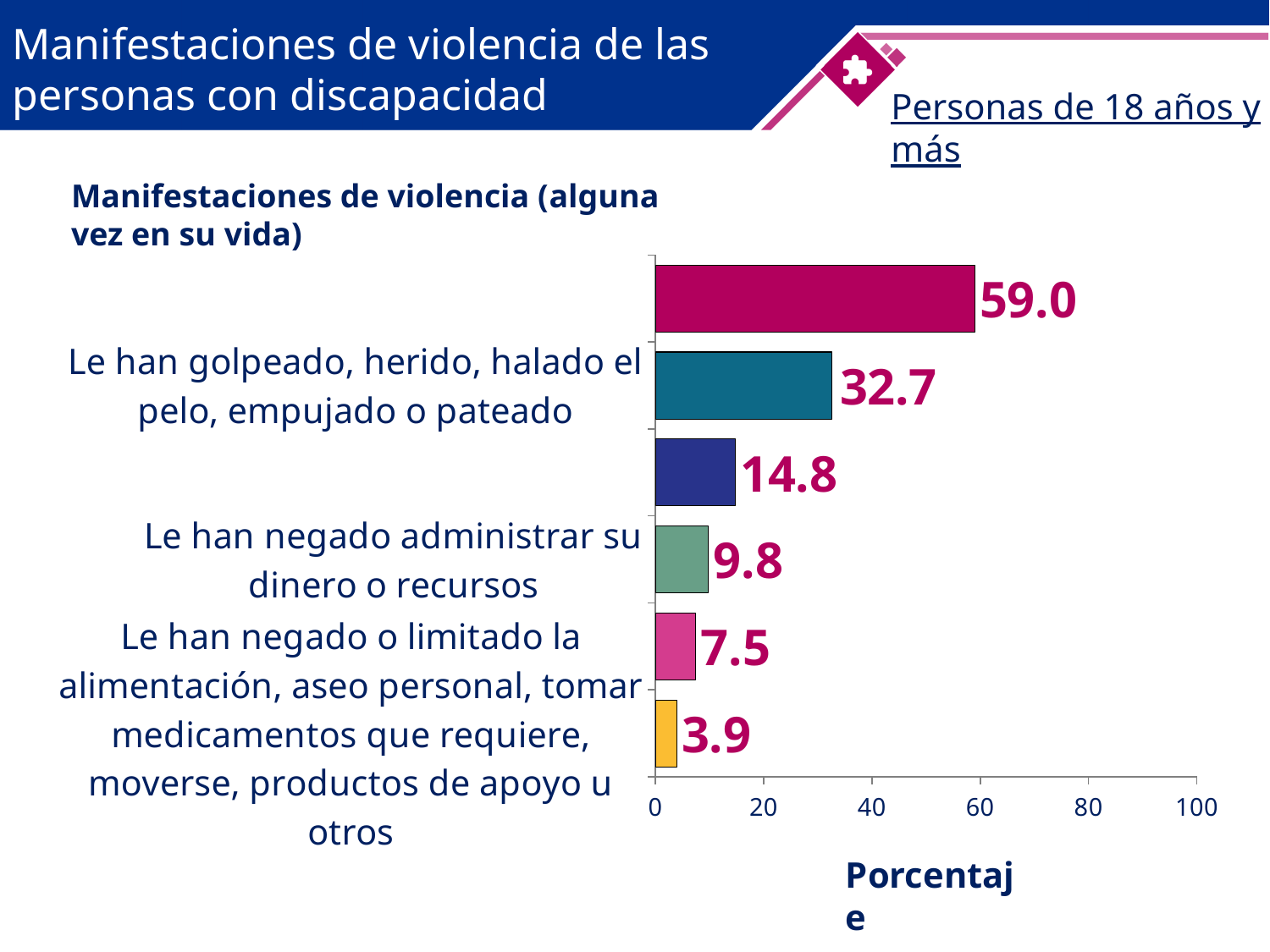
What is the value for 'Le han negado administrar su dinero o recursos'? 9.8 What is the value for 'Le han golpeado, herido, halado el pelo, empujado o pateado'? 32.7 What is the value of the fifth bar from the top? 7.5 How many bars are plotted in the chart? 6 What is the value of the longest bar in the chart? 59.0 What is the value of the shortest bar in the chart? 3.9 What is the label of the horizontal axis? Porcentaje What type of chart is shown on the slide? bar chart What is the value of the third bar from the top? 14.8 Which is larger: the value for 'Le han negado administrar su dinero o recursos' or the value of the bottom bar? Le han negado administrar su dinero o recursos Is the value of the top bar greater or less than 40? greater What is the difference between the top bar (59.0) and the bar for 'Le han golpeado, herido, halado el pelo, empujado o pateado' (32.7)? 26.3